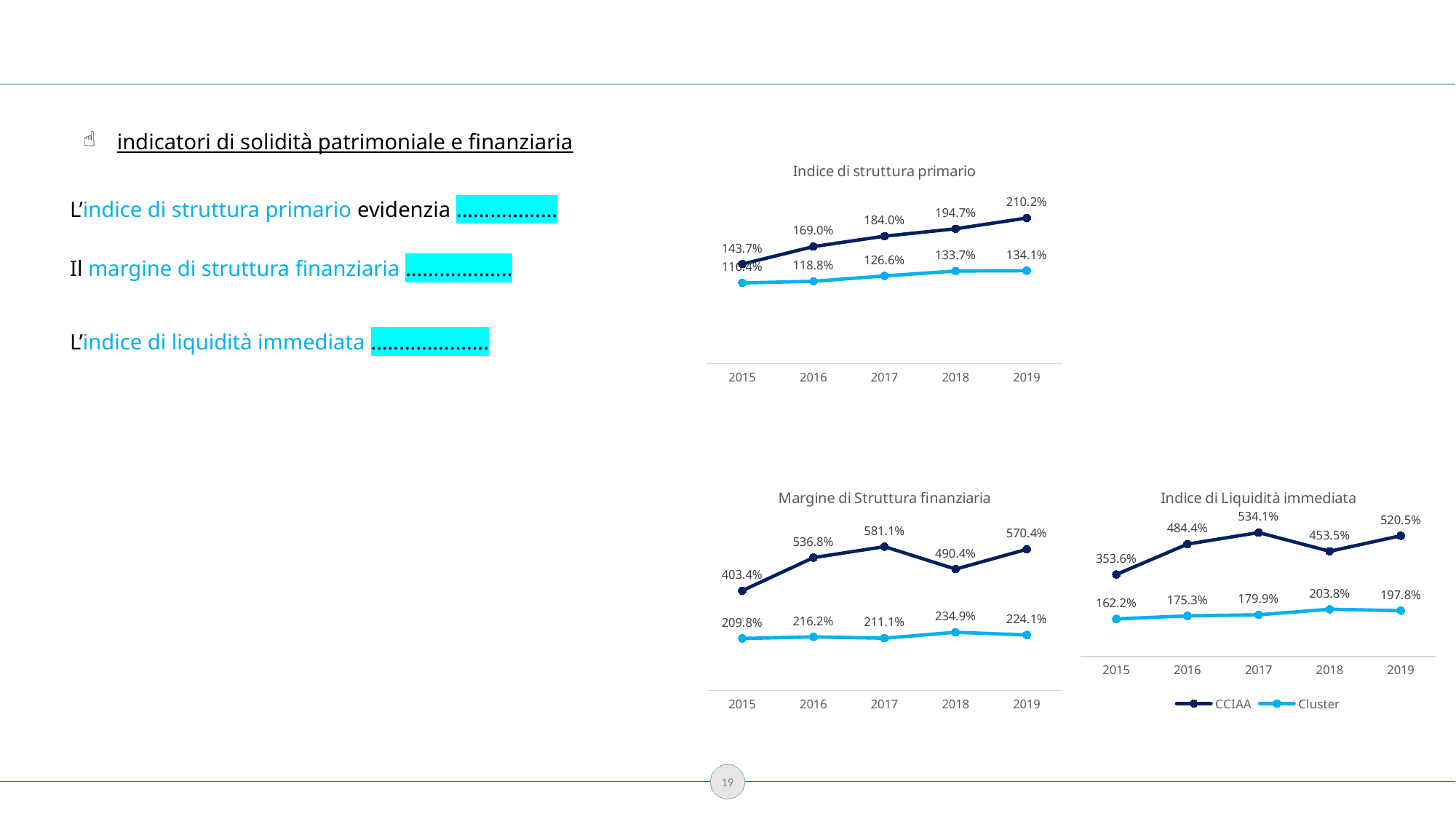
What type of chart is 'Margine di Struttura finanziaria'? line chart In the 'Indice di Liquidità immediata' chart, what is the difference between the CCIAA and Cluster values in 2015? 191.4% In the 'Indice di struttura primario' chart, what is the difference between the CCIAA and Cluster values in 2017? 57.4% How many series does the legend on the slide list? 2 In the 'Indice di struttura primario' chart, does the CCIAA series rise or fall from 2015 to 2019? rise In the 'Margine di Struttura finanziaria' chart, what is the Cluster value for 2018? 234.9% In the 'Indice di Liquidità immediata' chart, which is larger, the Cluster value for 2018 or for 2019? 2018 In the 'Indice di struttura primario' chart, what is the Cluster value for 2018? 133.7% In the 'Margine di Struttura finanziaria' chart, which year has the lowest CCIAA value? 2015 In the 'Indice di Liquidità immediata' chart, what is the CCIAA value for 2017? 534.1% In the 'Margine di Struttura finanziaria' chart, which year has the highest CCIAA value? 2017 In the 'Indice di struttura primario' chart, what is the CCIAA value for 2019? 210.2%